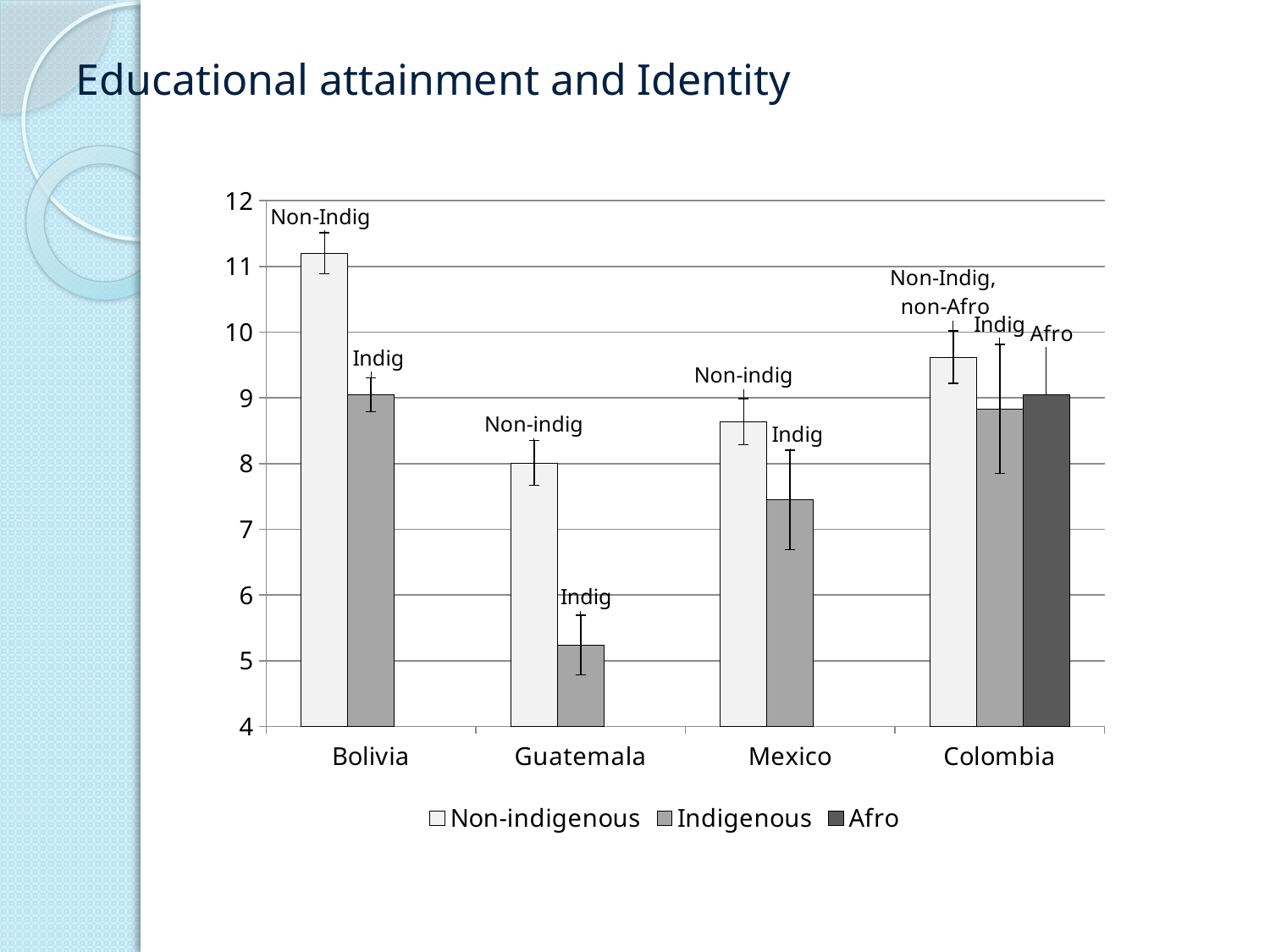
Which country has the lowest Non-indigenous bar? Guatemala Is the Non-indigenous value for Bolivia greater or less than 11? greater How many countries are shown on the x axis of the chart? 4 Is the Non-indigenous value for Colombia greater or less than 9? greater Is the Indigenous value for Mexico greater or less than 8? less How many series does the chart legend list? 3 Which country has the lowest Indigenous bar? Guatemala Which country is the only one with an Afro bar in the chart? Colombia In Mexico, which is larger: the Non-indigenous bar or the Indigenous bar? Non-indigenous What kind of chart is shown on the slide? bar chart Which country has the highest Non-indigenous bar? Bolivia